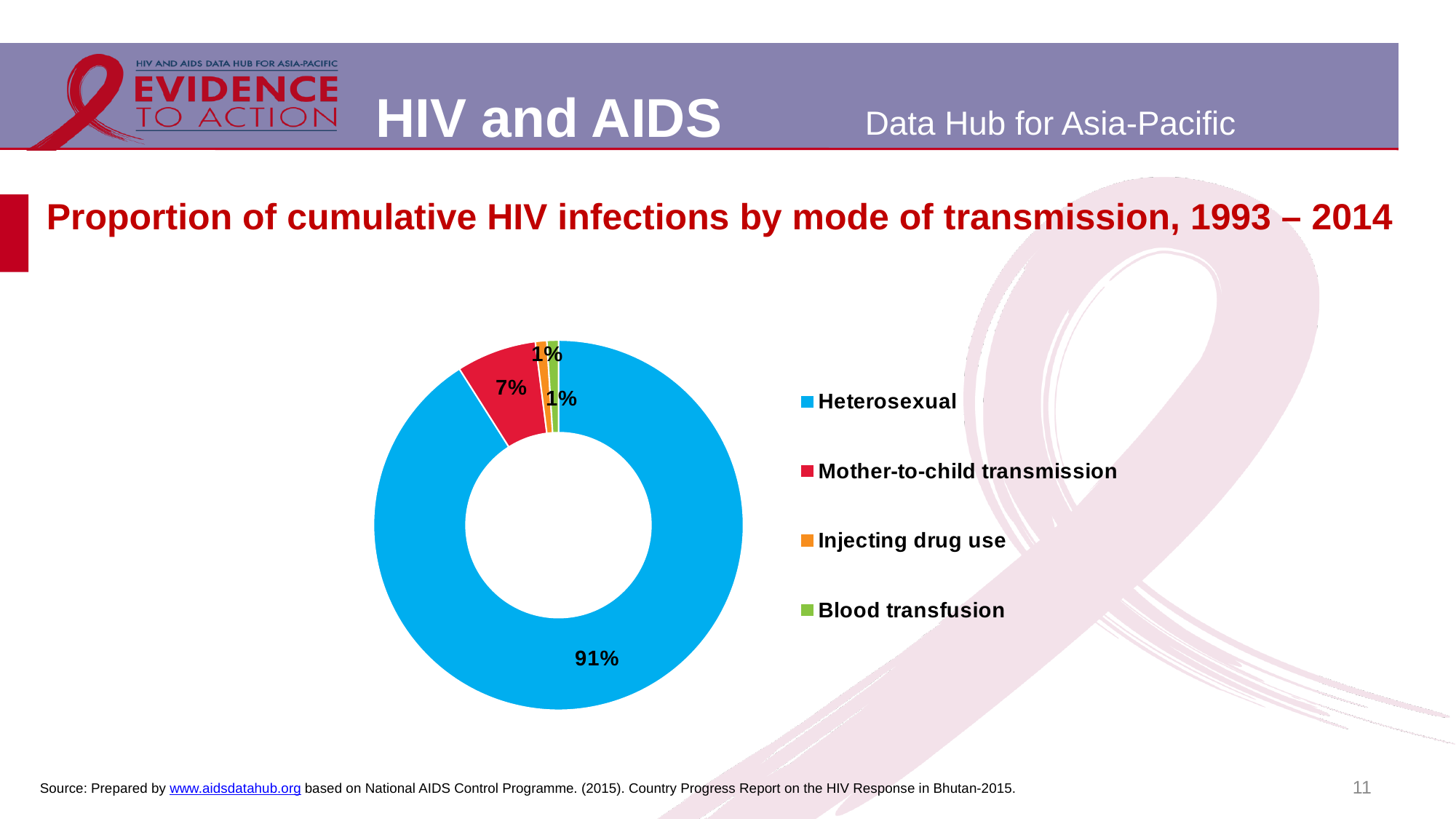
What share of cumulative HIV infections is attributed to injecting drug use? 1% What share of cumulative HIV infections is attributed to blood transfusion? 1% What colour represents mother-to-child transmission in the chart? Red What is the difference in percentage points between the mother-to-child transmission share and the injecting drug use share? 6 How many modes of transmission are shown in the chart? 4 What share of cumulative HIV infections is attributed to heterosexual transmission? 91% What type of chart is used to show the proportion of cumulative HIV infections by mode of transmission? Doughnut (pie) chart What is the difference in percentage points between the heterosexual and mother-to-child transmission shares? 84 What is the title of the chart? Proportion of cumulative HIV infections by mode of transmission, 1993 – 2014 What share of cumulative HIV infections is attributed to mother-to-child transmission? 7% Which is larger: the share for mother-to-child transmission or the share for blood transfusion? Mother-to-child transmission Which mode of transmission accounts for the largest share of cumulative HIV infections? Heterosexual